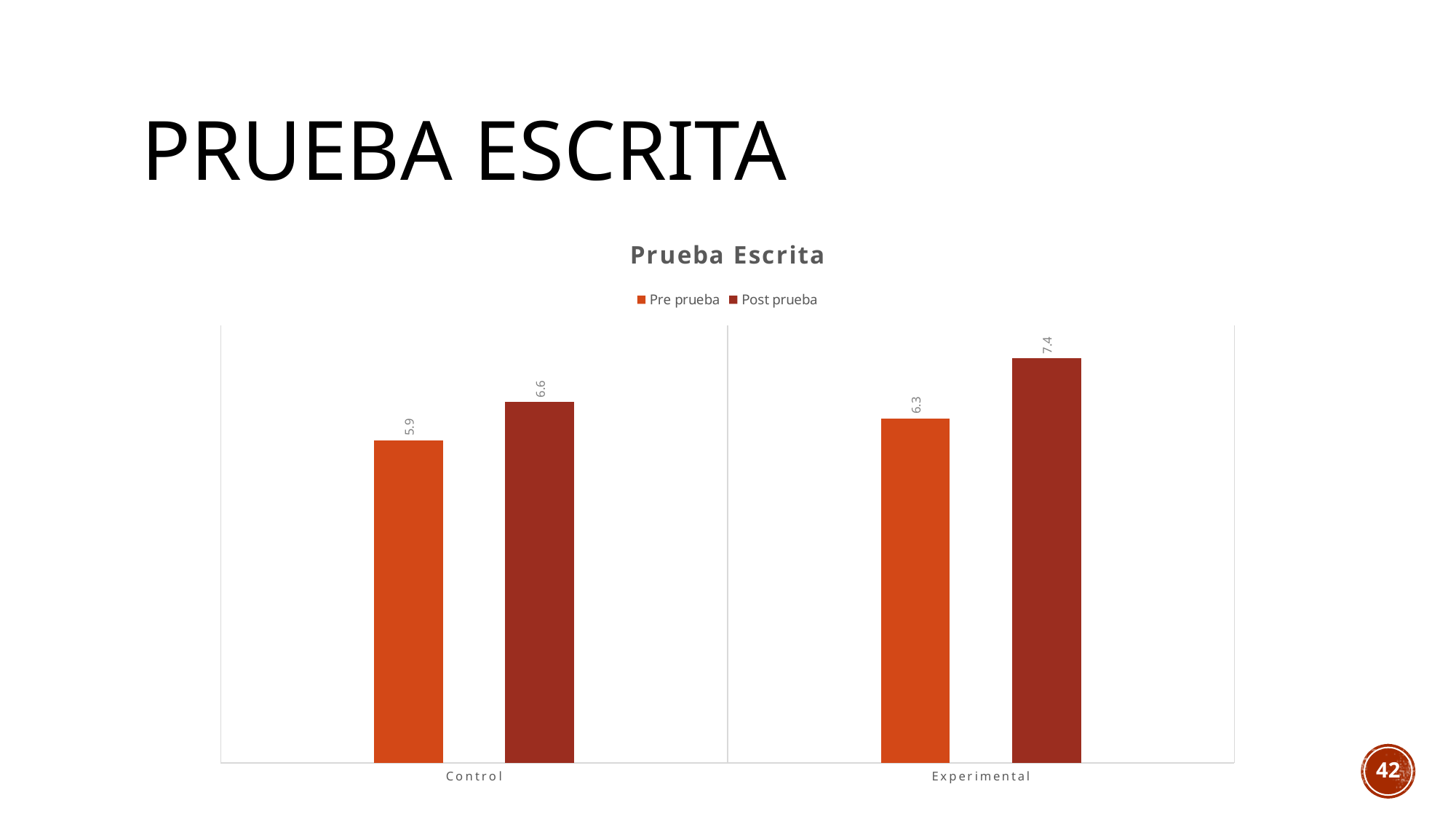
What is the Post prueba value for Control? 6.6 Which is larger: the Pre prueba value for Experimental or the Post prueba value for Control? Post prueba value for Control Which group has the highest Post prueba value? Experimental What is the Pre prueba value for Experimental? 6.3 What is the difference between the Post prueba and Pre prueba values for Experimental? 1.1 What is the Pre prueba value for Control? 5.9 What is the difference between the Post prueba and Pre prueba values for Control? 0.7 Which group has the lowest Pre prueba value? Control How many groups are shown on the x axis? 2 How many series does the legend list? 2 What is the Post prueba value for Experimental? 7.4 What kind of chart is shown on the slide? Bar chart